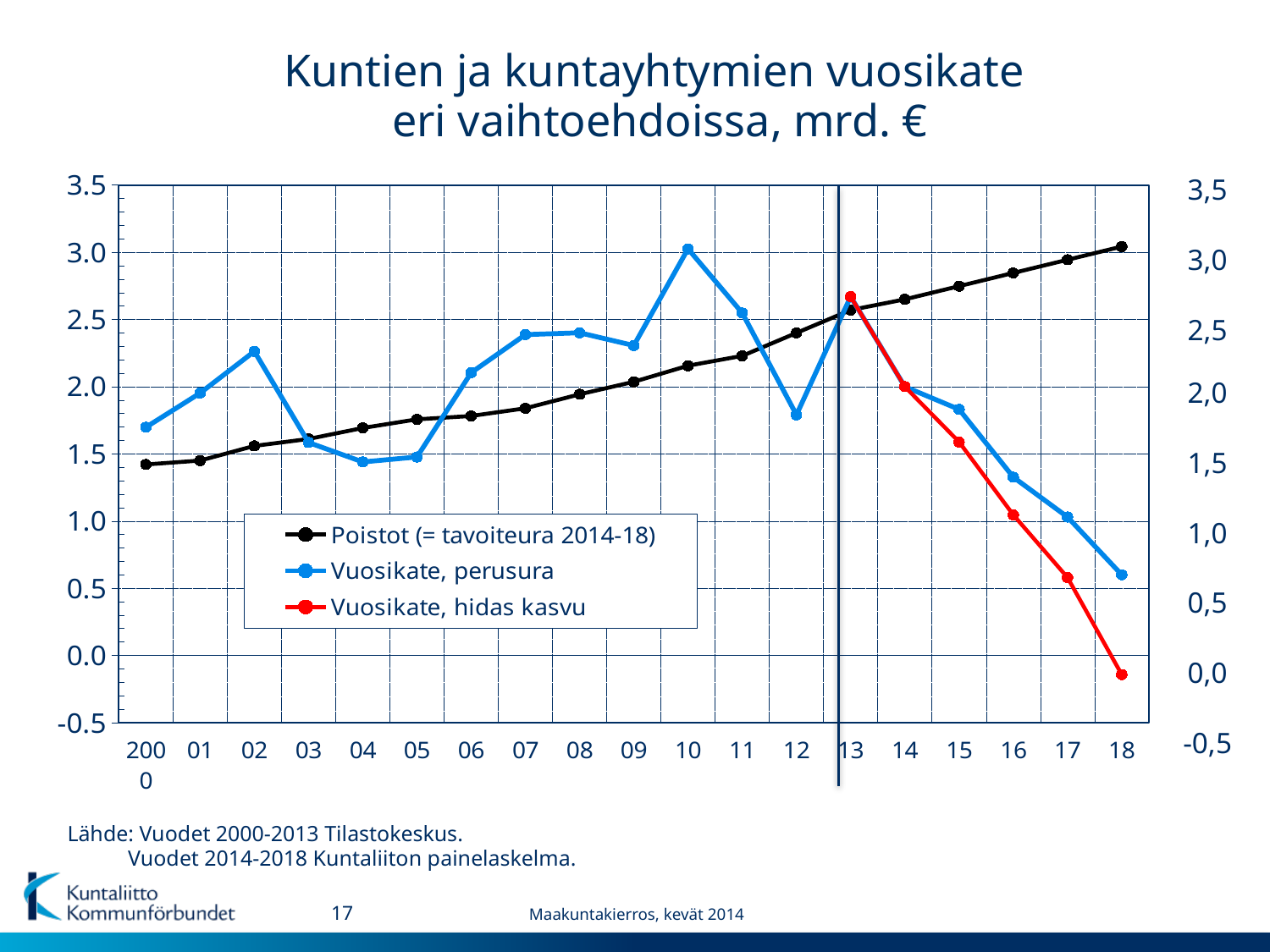
Does the 'Vuosikate, hidas kasvu' series rise or fall from 13 to 18? fall Does the 'Poistot (= tavoiteura 2014-18)' series rise or fall from 2000 to 18? rise In which year does the 'Vuosikate, hidas kasvu' series reach its lowest value? 18 In year 10, which is larger: 'Poistot (= tavoiteura 2014-18)' or 'Vuosikate, perusura'? Vuosikate, perusura In year 12, which is larger: 'Poistot (= tavoiteura 2014-18)' or 'Vuosikate, perusura'? Poistot (= tavoiteura 2014-18) What kind of chart is shown on the slide? line chart Is the value for 'Vuosikate, perusura' in year 12 greater or less than 1,5? greater In which year does the 'Vuosikate, perusura' series reach its highest value? 10 How many series does the legend list? 3 Is the value for 'Vuosikate, hidas kasvu' in year 18 greater or less than 0,0? less How many years are shown along the x axis? 19 Which colour is used for the 'Vuosikate, hidas kasvu' series? red